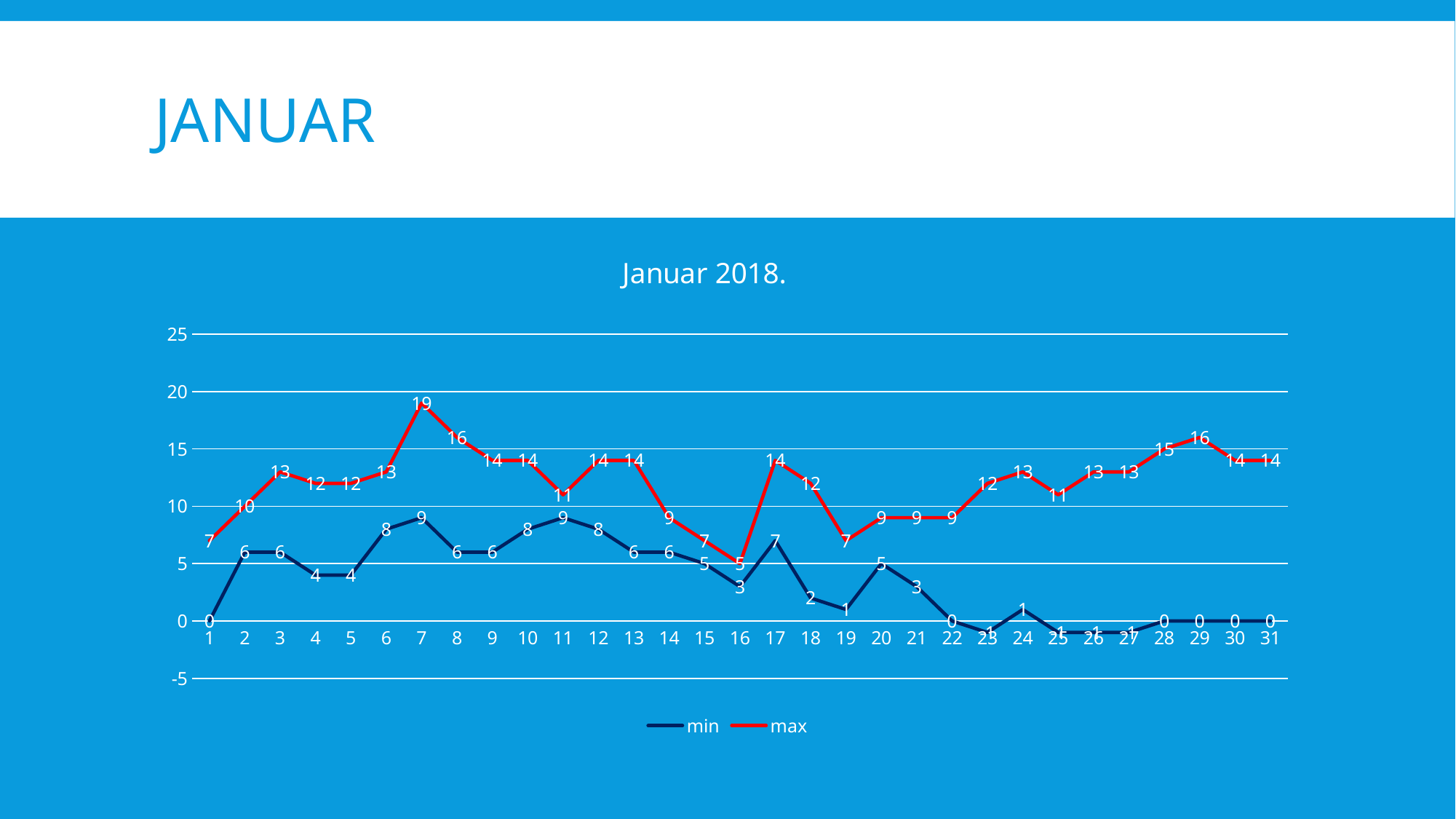
What kind of chart is shown on the slide? line chart What is the max value on day 7? 19 What is the min value on day 17? 7 How many series does the legend list? 2 On which day is the max series at its lowest? 16 How many days are plotted along the x axis? 31 Does the min series rise or fall from day 17 to day 19? fall What is the title of the chart? Januar 2018. What is the difference between the max and min values on day 7? 10 On which day is the max series at its highest? 7 Is the max value on day 7 greater or less than 15? greater Which is larger, the min value on day 2 or the min value on day 20? day 2